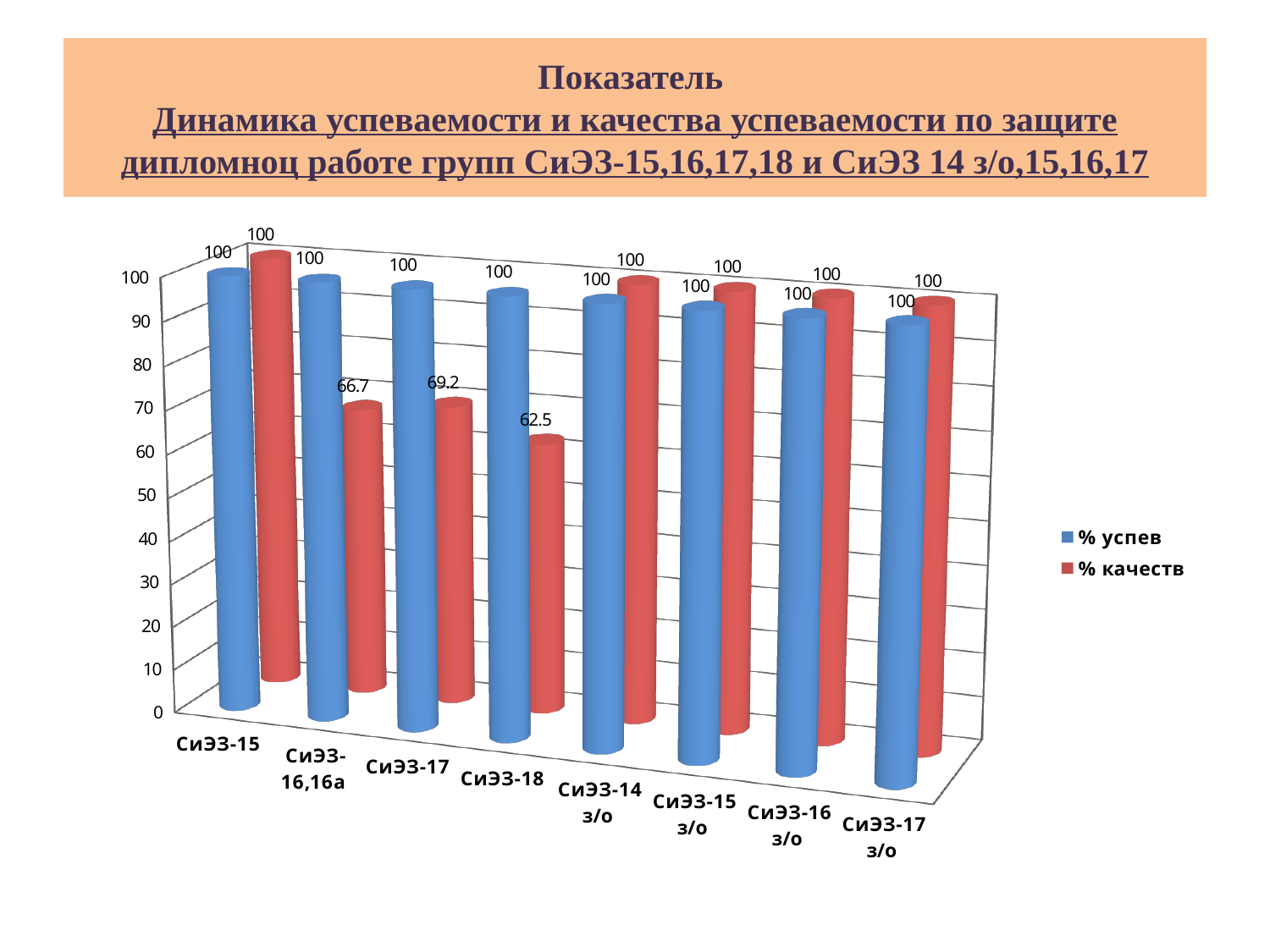
What is the value of % успев for СиЭЗ-14 з/о? 100 Which colour represents the % качеств series? red How many series does the legend list? 2 What is the value of % качеств for СиЭЗ-18? 62.5 Which group has the lowest % качеств value? СиЭЗ-18 Is the % качеств value for СиЭЗ-18 greater or less than 70? less What is the value of % качеств for СиЭЗ-17? 69.2 What kind of chart is shown on the slide? bar chart How many groups (categories) are shown on the x axis? 8 What is the difference between % успев and % качеств for СиЭЗ-16,16а? 33.3 Which is larger for СиЭЗ-17: % успев or % качеств? % успев What is the value of % качеств for СиЭЗ-16,16а? 66.7